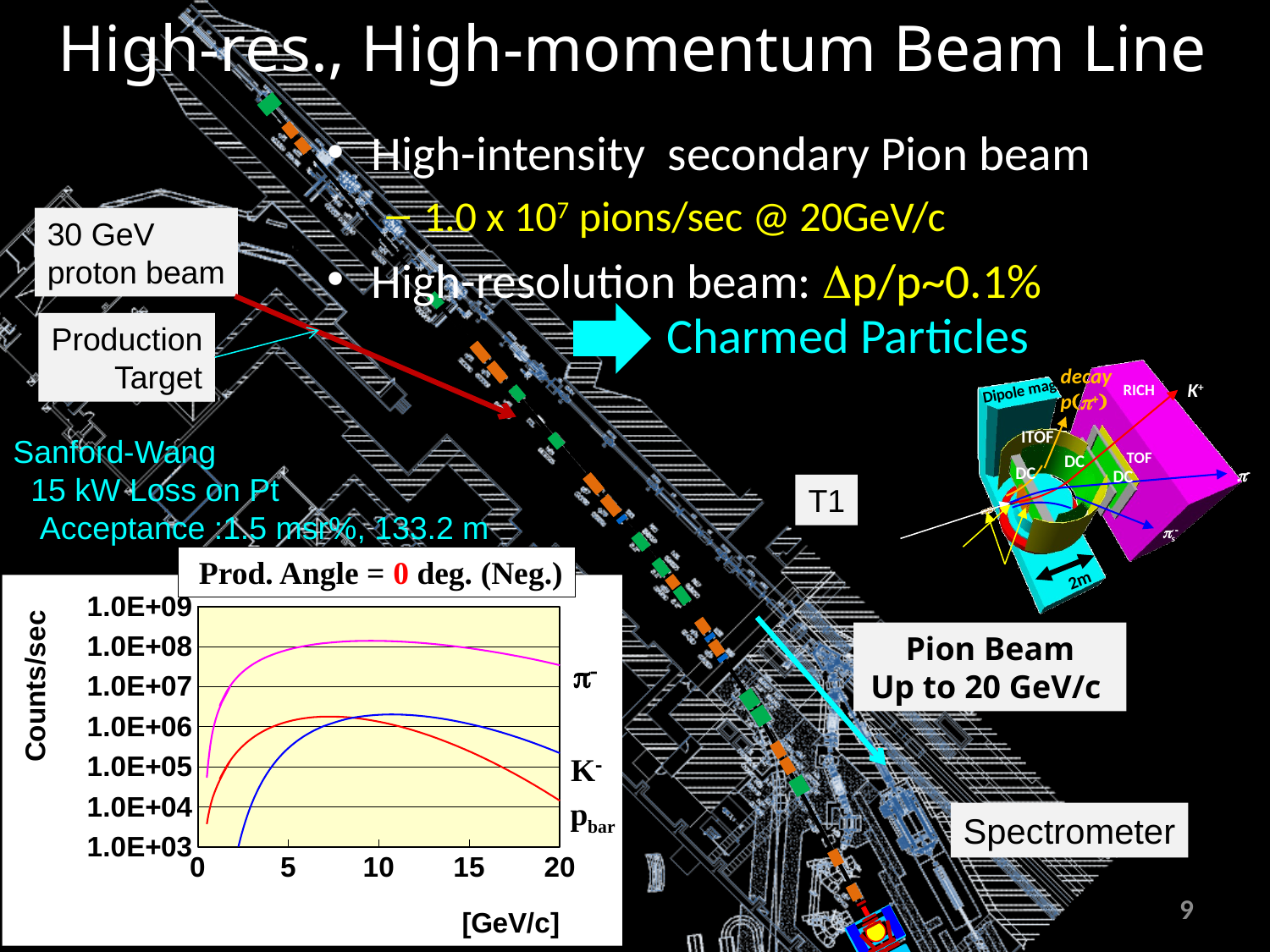
What is the title of the chart? Prod. Angle = 0 deg. (Neg.) Is the value for p_bar at 20 GeV/c greater or less than 1.0E+05 counts/sec? less At 20 GeV/c, which is larger in the chart: the K⁻ curve or the p_bar curve? K⁻ Is the value for K⁻ at 10 GeV/c greater or less than 1.0E+06 counts/sec? greater How many curves (series) are plotted in the chart? 3 Does the π⁻ curve rise or fall between 10 GeV/c and 20 GeV/c? fall What is the label of the chart's y axis? Counts/sec Which series has the highest counts/sec across the momentum range in the chart? π⁻ Which series has the lowest counts/sec at 20 GeV/c in the chart? p_bar What kind of chart is shown at the bottom left of the slide? line chart Is the value for K⁻ at 10 GeV/c greater or less than 1.0E+07 counts/sec? less